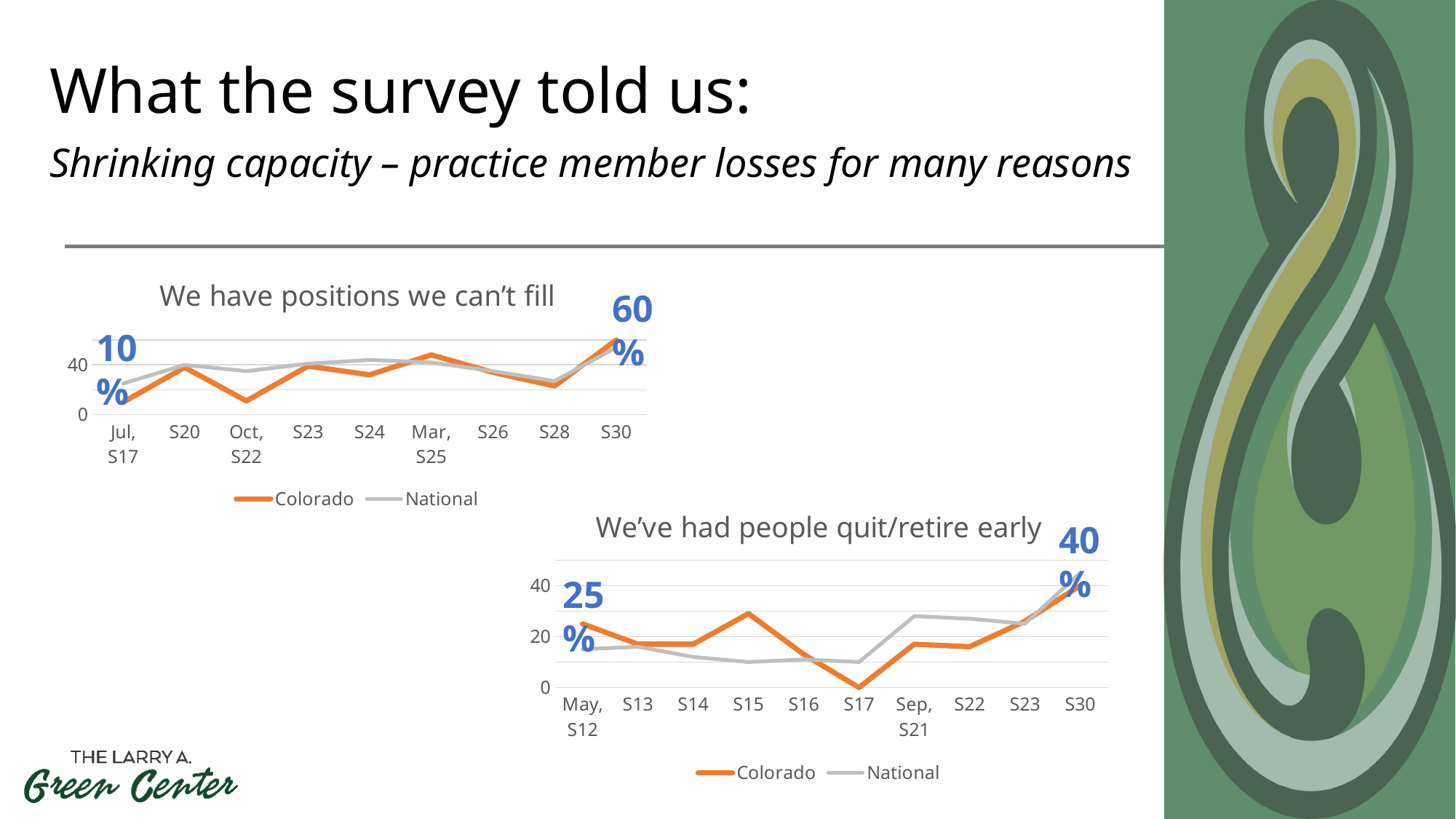
In the "We've had people quit/retire early" chart, how many survey points are plotted along the x axis? 10 In the "We have positions we can't fill" chart, what is the labelled Colorado value at Jul, S17? 10% In the "We have positions we can't fill" chart, by how many percentage points did the Colorado value rise from Jul, S17 to S30? 50 In the "We have positions we can't fill" chart, how many survey points are plotted along the x axis? 9 In the "We've had people quit/retire early" chart, is the Colorado value at S15 greater or less than 20? greater In the "We've had people quit/retire early" chart, what is the labelled Colorado value at S30? 40% What kind of chart is "We have positions we can't fill"? line chart In the "We've had people quit/retire early" chart, at which survey point is the Colorado value lowest? S17 In the "We have positions we can't fill" chart, what is the labelled Colorado value at S30? 60% In the "We have positions we can't fill" chart, at Oct, S22, which series is higher, Colorado or National? National In the "We have positions we can't fill" chart, how many series does the legend list? 2 In the "We have positions we can't fill" chart, is the Colorado value at Oct, S22 greater or less than 40? less